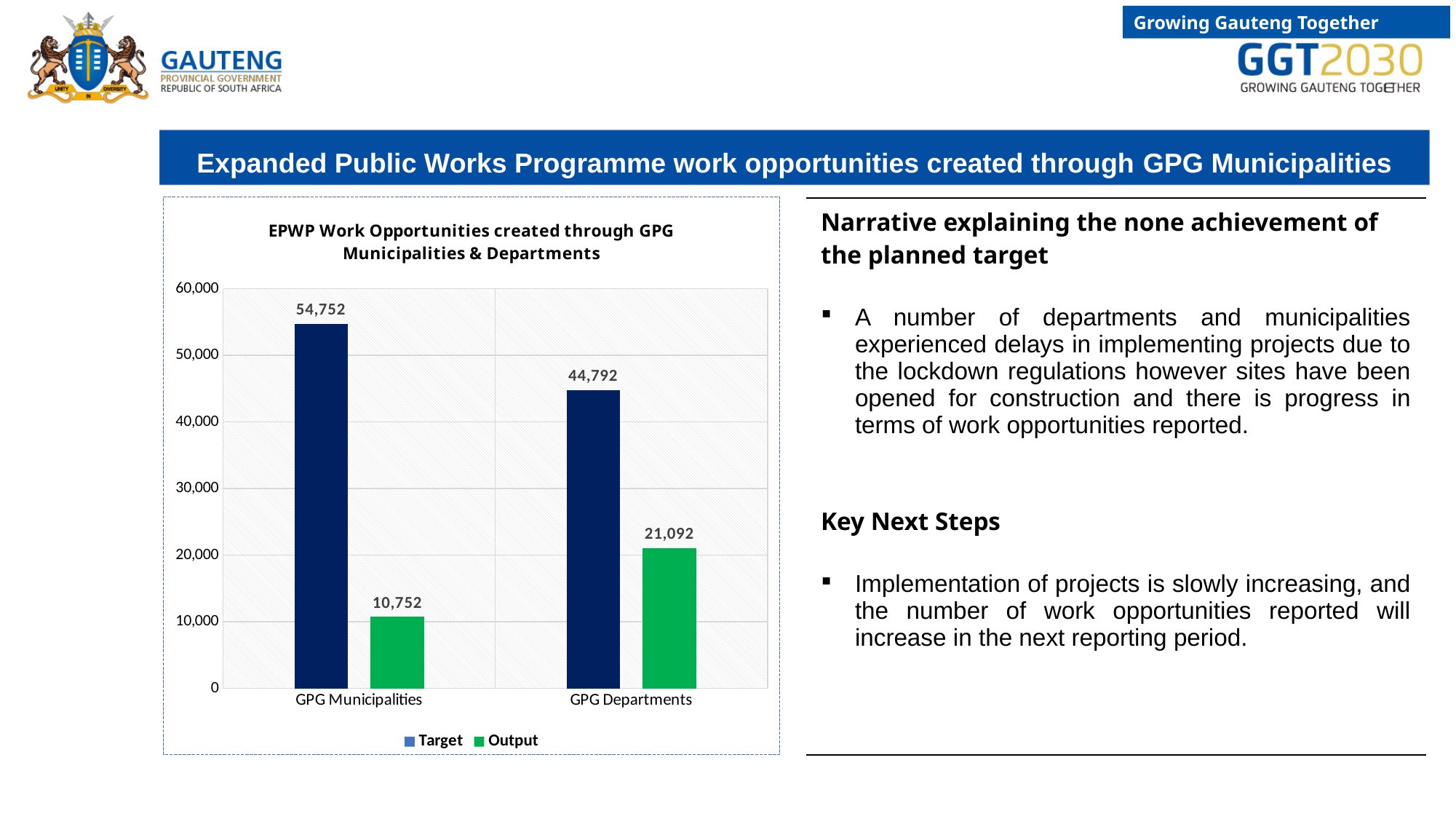
What kind of chart is shown on the slide? bar chart What is the Output value for GPG Departments? 21,092 What is the difference between the Target and Output values for GPG Municipalities? 44,000 What is the Output value for GPG Municipalities? 10,752 What is the Target value for GPG Departments? 44,792 Which category has the lower Output value? GPG Municipalities How many series does the legend list? 2 What is the Target value for GPG Municipalities? 54,752 Which category has the higher Target value? GPG Municipalities What is the difference between the Target and Output values for GPG Departments? 23,700 What is the title of the chart? EPWP Work Opportunities created through GPG Municipalities & Departments Is the Output for GPG Departments larger or smaller than the Output for GPG Municipalities? larger